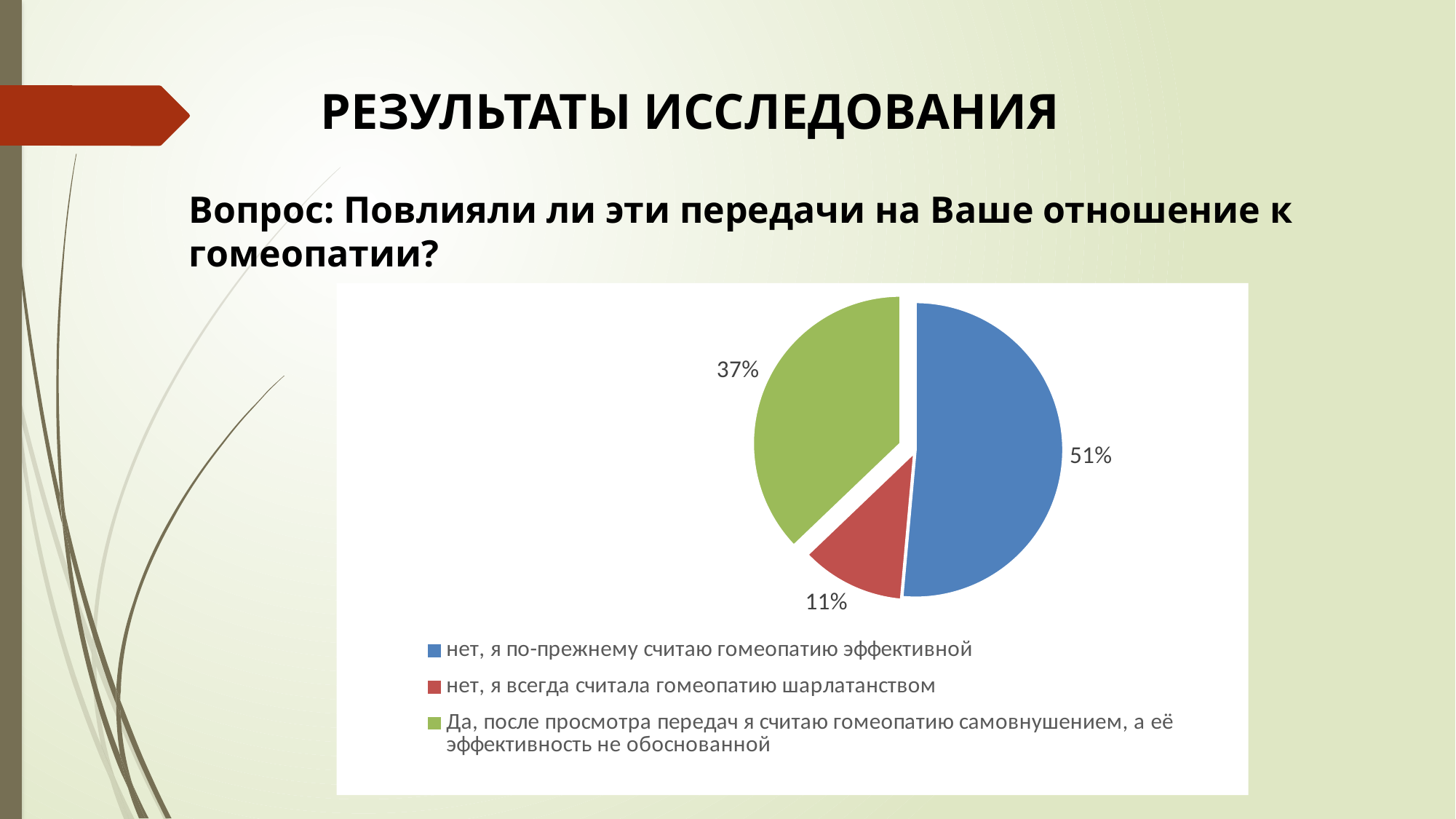
Which response has the largest share of the pie? нет, я по-прежнему считаю гомеопатию эффективной What share of the pie is labelled "нет, я всегда считала гомеопатию шарлатанством"? 11% What is the difference in percentage points between the 51% slice and the 37% slice? 14 Which is larger: the share for "нет, я всегда считала гомеопатию шарлатанством" or the share for "Да, после просмотра передач я считаю гомеопатию самовнушением, а её эффективность не обоснованной"? Да, после просмотра передач я считаю гомеопатию самовнушением, а её эффективность не обоснованной What is the difference in percentage points between the largest slice (51%) and the smallest slice (11%)? 40 What survey question is the pie chart about? Повлияли ли эти передачи на Ваше отношение к гомеопатии? Which response has the smallest share of the pie? нет, я всегда считала гомеопатию шарлатанством What kind of chart is shown on the slide? pie chart How many slices does the pie chart have? 3 What share of the pie is labelled "Да, после просмотра передач я считаю гомеопатию самовнушением, а её эффективность не обоснованной"? 37% What share of the pie is labelled "нет, я по-прежнему считаю гомеопатию эффективной"? 51% What colour is the slice labelled 37%? green